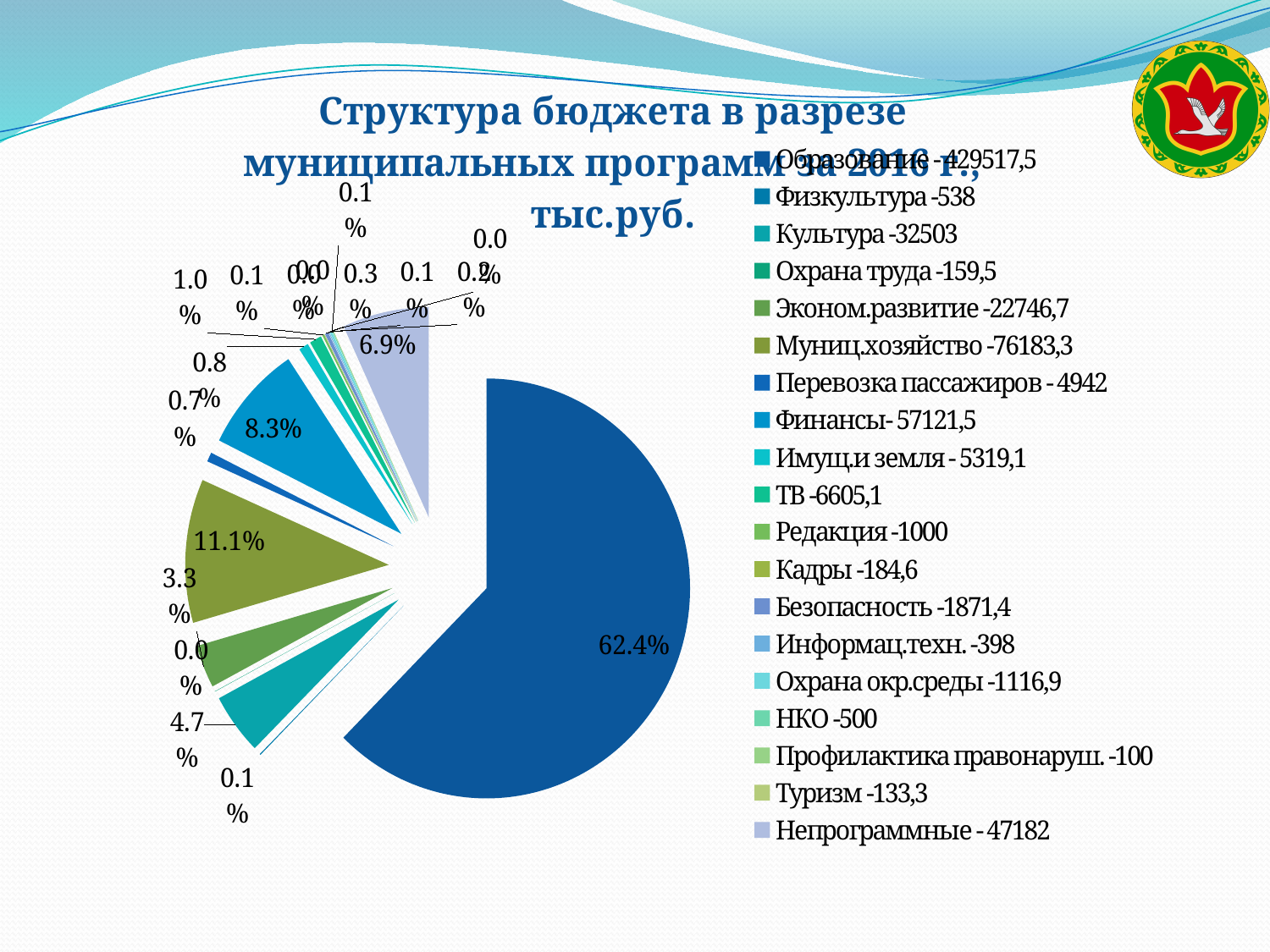
What value is shown in the legend for Муниц.хозяйство? 76183,3 What value is shown in the legend for Финансы? 57121,5 How many categories does the legend list? 19 What share of the pie does the largest slice (Образование) take? 62.4% What value is shown in the legend for Профилактика правонаруш.? 100 What kind of chart is shown on the slide? pie chart What is the title of the chart? Структура бюджета в разрезе муниципальных программ за 2016 г., тыс.руб. Which is larger, the value for Финансы or the value for Муниц.хозяйство? Муниц.хозяйство What value is shown in the legend for Непрограммные? 47182 What share of the pie is labelled 11.1%? Муниц.хозяйство Which category has the largest slice of the pie? Образование What is the difference between the legend values for Редакция and НКО? 500